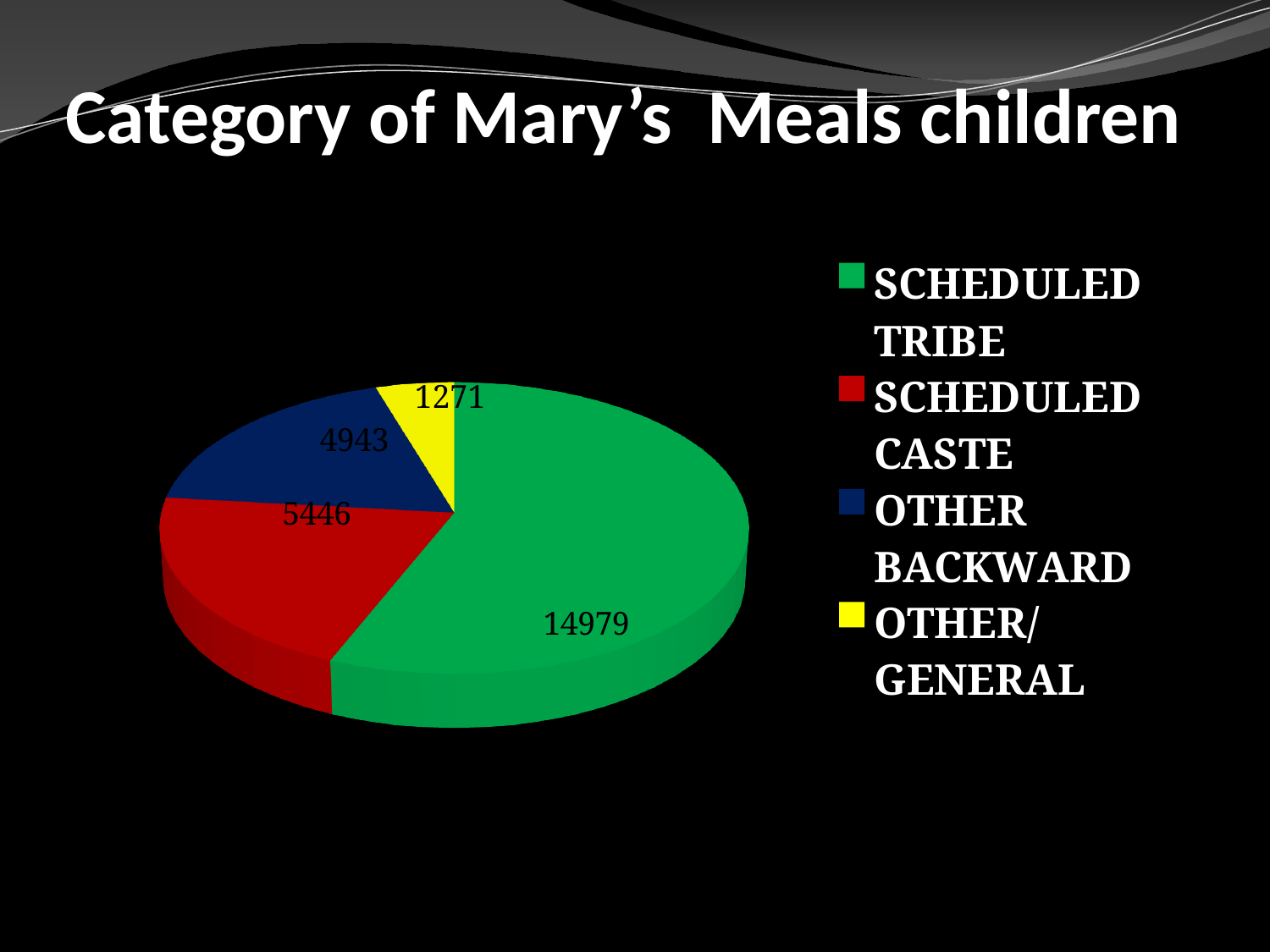
What is the value for Scheduled Tribe? 14979 What is the title of the chart? Category of Mary's Meals children What is the value for Other Backward? 4943 Which is larger, Scheduled Caste or Other Backward? Scheduled Caste What is the difference between the Scheduled Tribe and Scheduled Caste values? 9533 How many categories does the pie chart have? 4 Which category has the smallest slice? Other/General Which category has the largest slice? Scheduled Tribe What is the value for Other/General? 1271 What is the value for Scheduled Caste? 5446 What type of chart is shown on the slide? Pie chart What is the difference between the Scheduled Caste and Other Backward values? 503